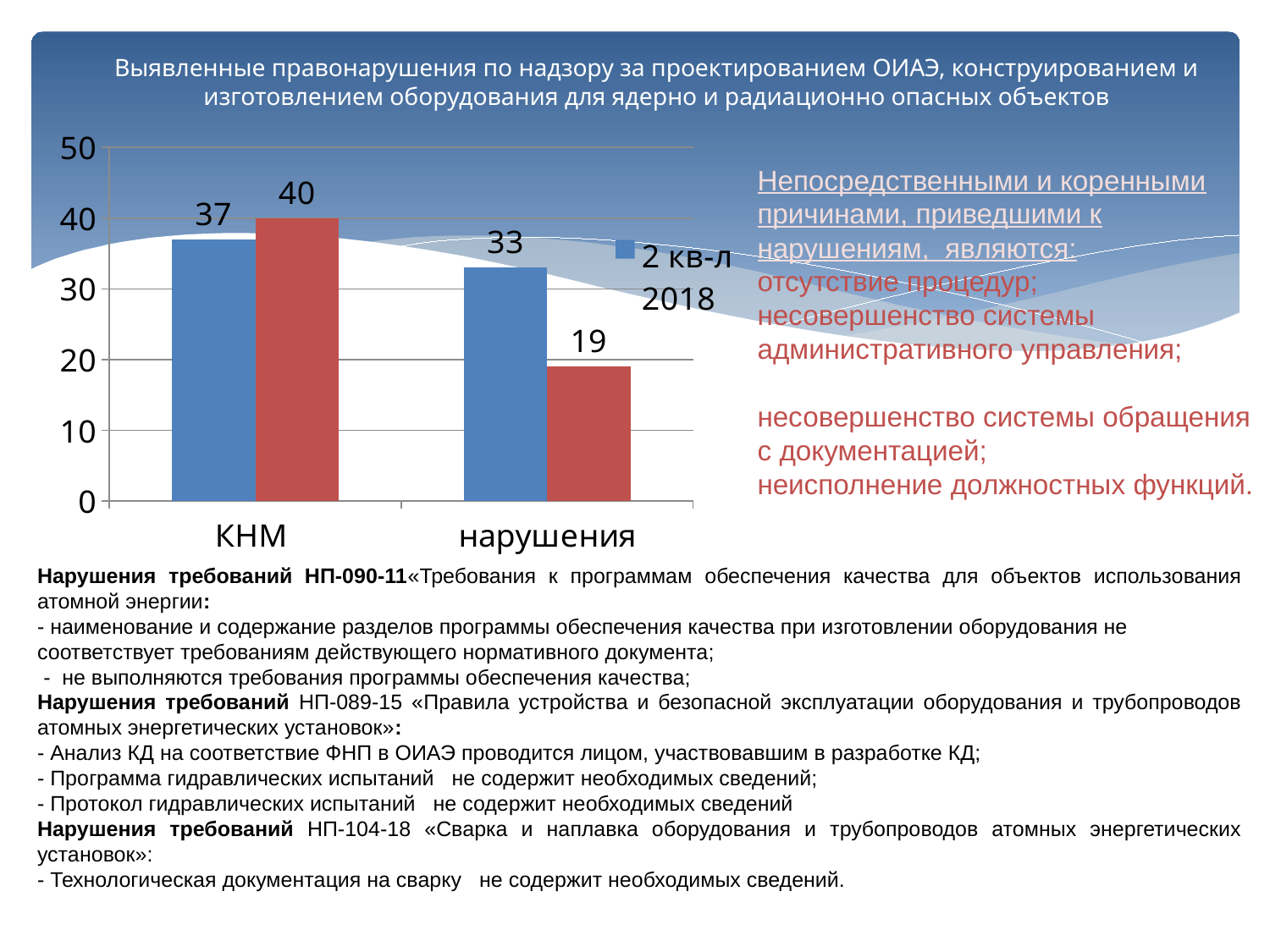
What kind of chart is shown on the slide? bar chart What is the value of the red series for КНМ? 40 How many categories are shown on the x axis of the chart? 2 For нарушения, which is larger: the blue bar or the red bar? the blue bar What is the value of the red series for нарушения? 19 Which bar in the chart has the lowest value? red series, нарушения (19) What is the difference between the red and blue bars for КНМ? 3 What is the value of the blue series (2 кв-л 2018) for нарушения? 33 Which legend entry is readable in the chart? 2 кв-л 2018 Which bar in the chart has the highest value? red series, КНМ (40) What is the value of the blue series (2 кв-л 2018) for КНМ? 37 What is the difference between the blue and red bars for нарушения? 14